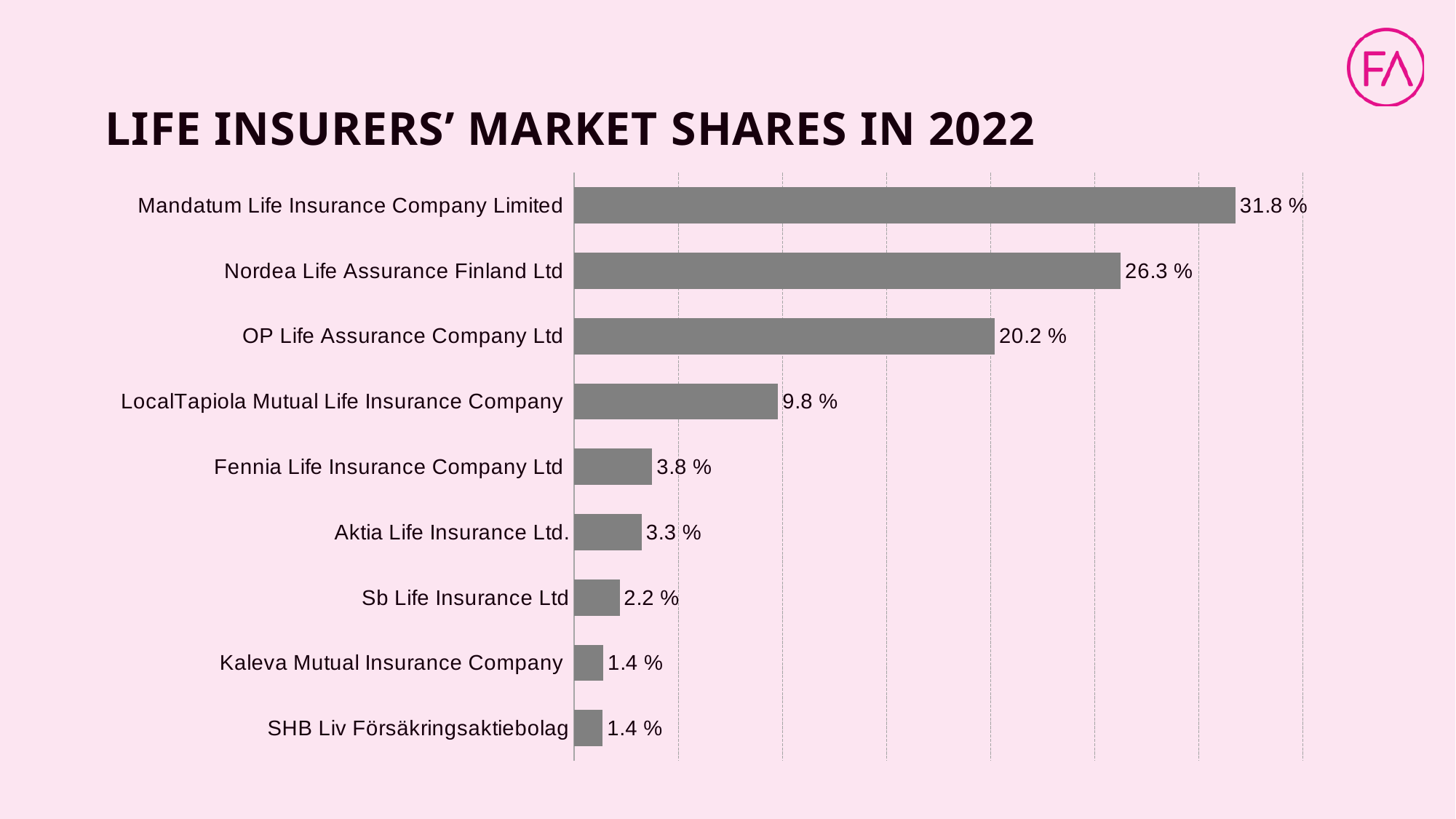
What is the market share of Mandatum Life Insurance Company Limited? 31.8 % What is the title of the chart on the slide? LIFE INSURERS' MARKET SHARES IN 2022 How many life insurers are shown in the chart? 9 What is the combined market share of Kaleva Mutual Insurance Company and SHB Liv Försäkringsaktiebolag? 2.8 % Which life insurer has the highest market share? Mandatum Life Insurance Company Limited What kind of chart is shown on the slide? Bar chart What is the difference in market share between Fennia Life Insurance Company Ltd and Aktia Life Insurance Ltd.? 0.5 % What is the market share of OP Life Assurance Company Ltd? 20.2 % What is the difference in market share between Mandatum Life Insurance Company Limited and Nordea Life Assurance Finland Ltd? 5.5 % What is the market share of Sb Life Insurance Ltd? 2.2 % Which has a larger market share, LocalTapiola Mutual Life Insurance Company or OP Life Assurance Company Ltd? OP Life Assurance Company Ltd